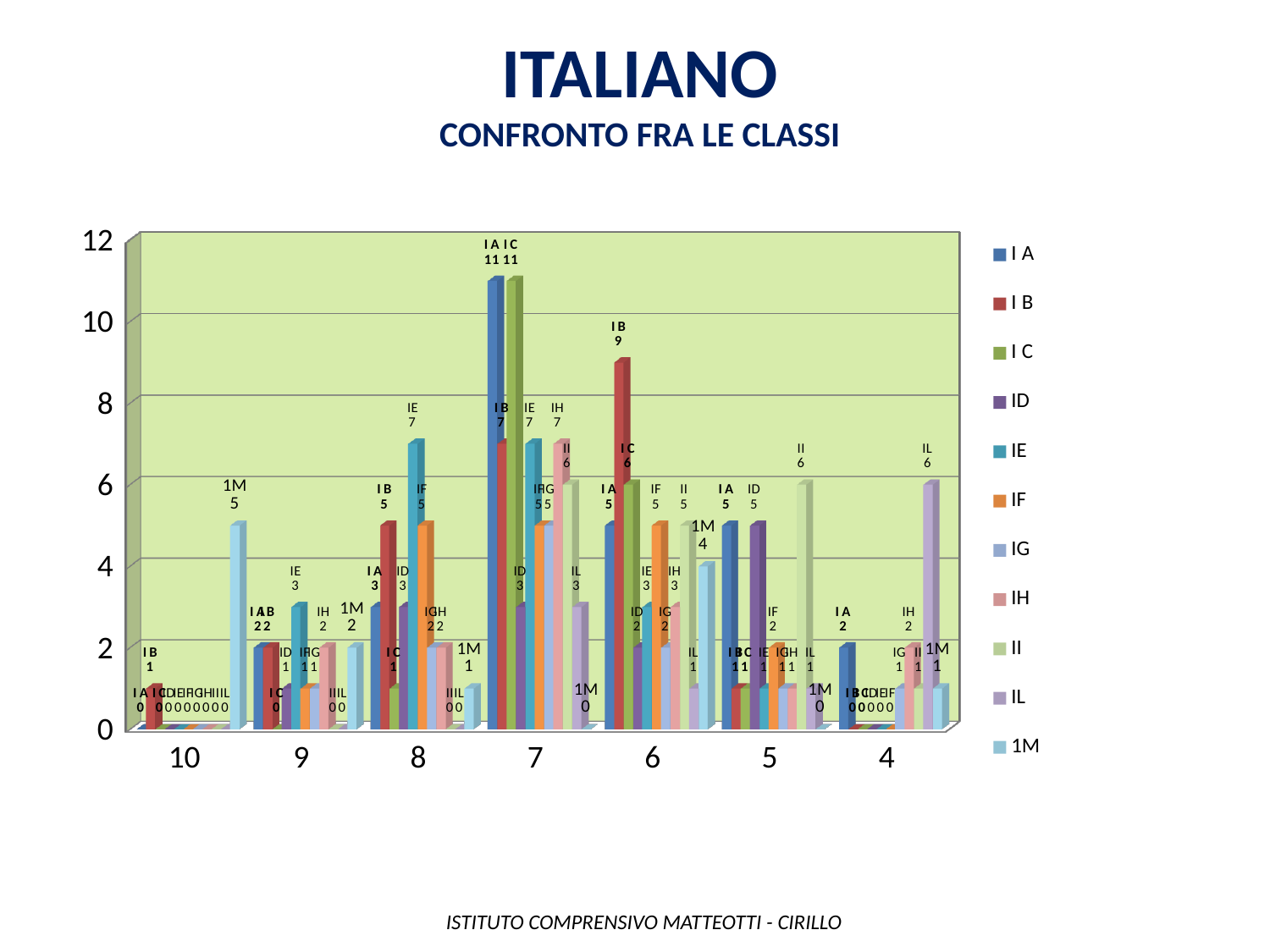
Which is larger at category 5: II or ID? II What is the value for IL at category 4? 6 What is the subtitle of the chart? CONFRONTO FRA LE CLASSI What is the value for I B at category 6? 9 What is the difference between I A and I B at category 7? 4 How many categories are shown on the x axis? 7 What kind of chart is shown on the slide? bar chart What is the value for IE at category 8? 7 What is the value for 1M at category 10? 5 Is the value for I A at category 7 greater or less than 10? greater How many series does the legend list? 11 Which series has the highest value at category 6? I B